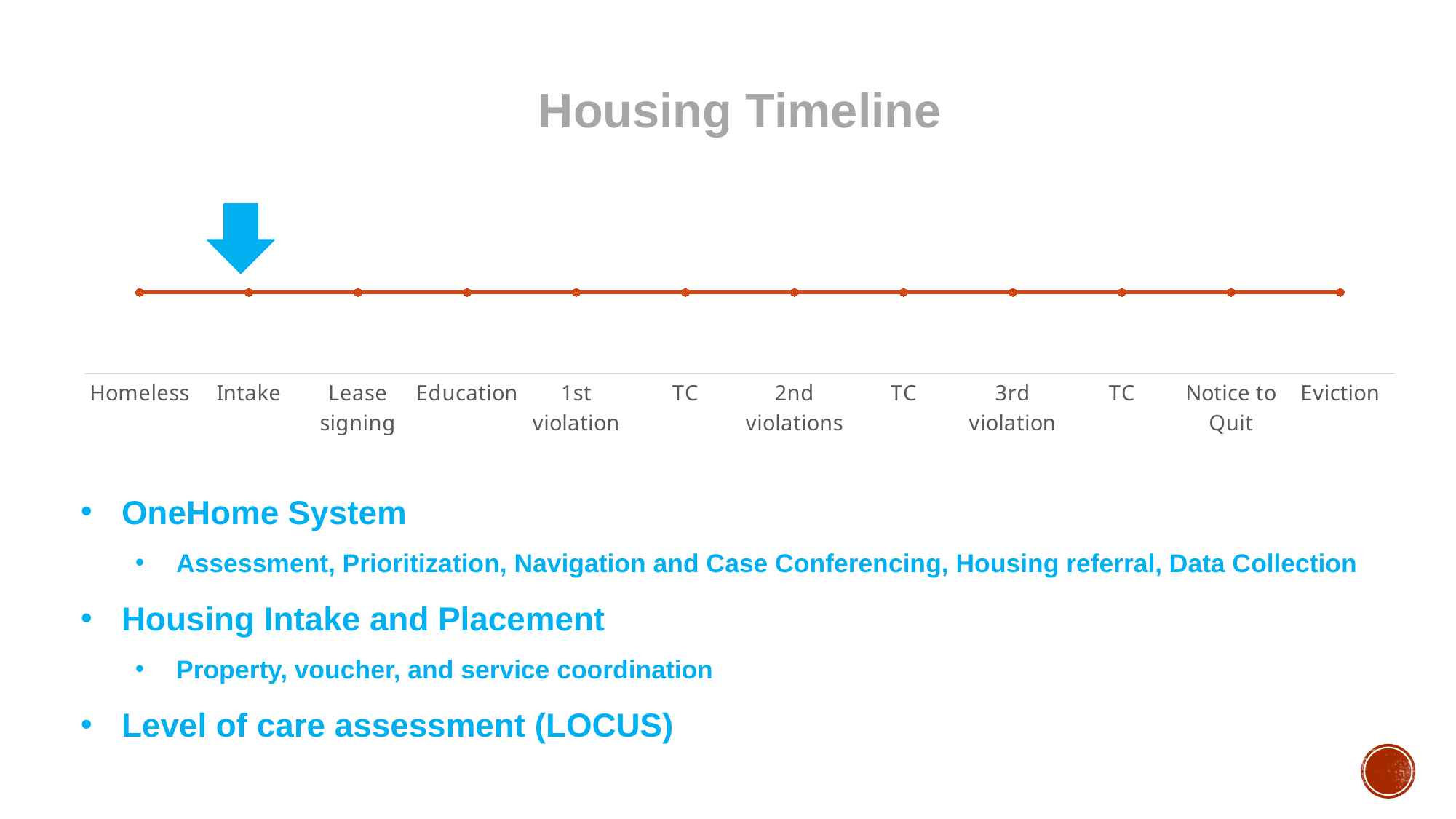
What is the last category on the right of the Housing Timeline? Eviction What is the title of the chart on the slide? Housing Timeline Which category comes immediately before Eviction on the Housing Timeline? Notice to Quit How many categories on the Housing Timeline are labelled "TC"? 3 Do the plotted values rise, fall, or stay flat along the Housing Timeline from Homeless to Eviction? Stay flat How many points are plotted along the Housing Timeline? 12 What kind of chart is used to show the Housing Timeline? Line chart